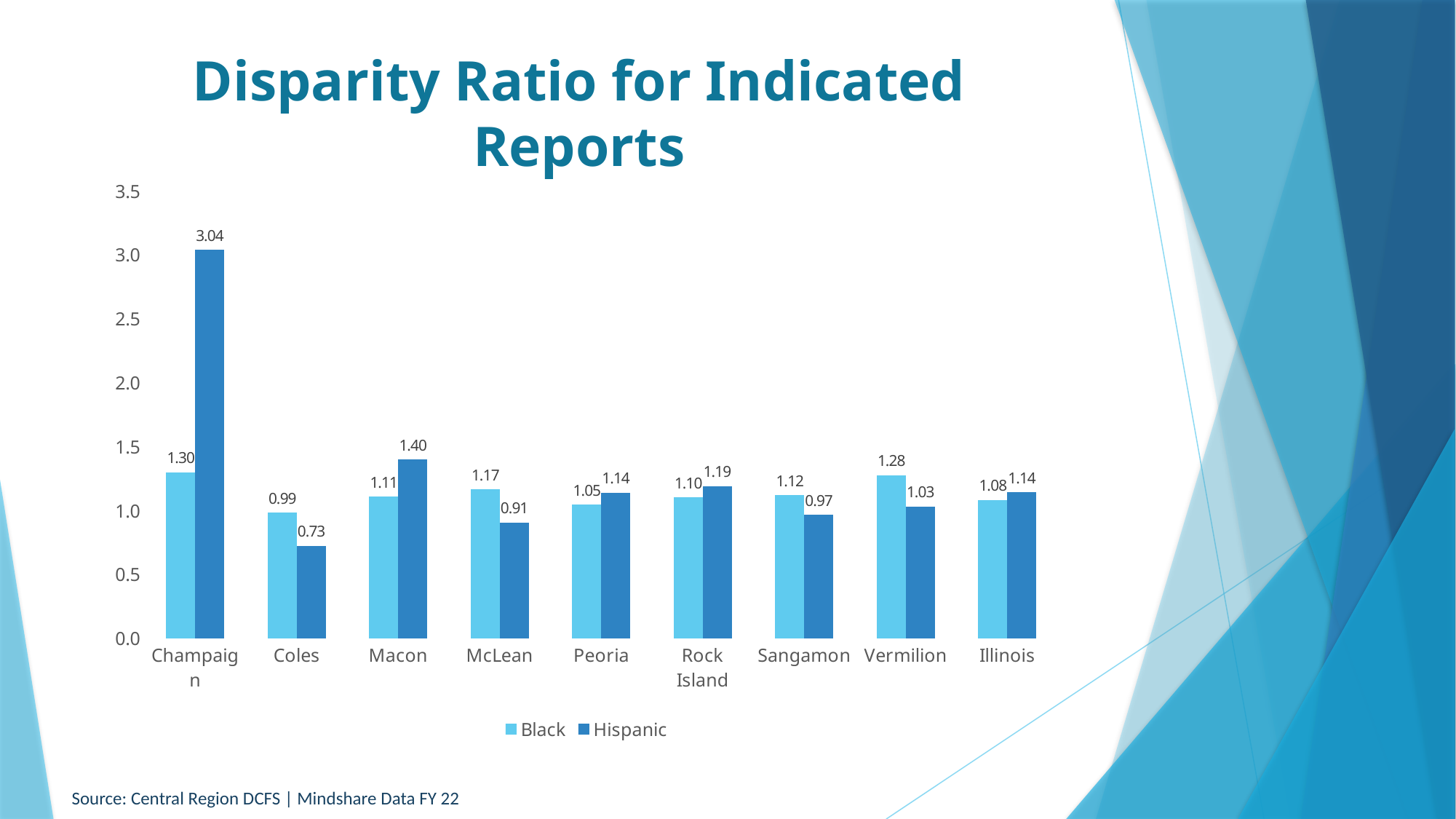
Which category has the lowest Black disparity ratio? Coles How many series does the legend list? 2 Is the Hispanic value for Champaign greater or less than 3.0? greater How many categories are shown on the x axis? 9 What is the difference between the Hispanic and Black disparity ratios for Champaign? 1.74 What kind of chart is shown on the slide? Bar chart Which is larger for McLean, the Black or the Hispanic disparity ratio? Black What is the Black disparity ratio for Vermilion? 1.28 What is the title of the chart? Disparity Ratio for Indicated Reports What is the Hispanic disparity ratio for Coles? 0.73 What is the Hispanic disparity ratio for Champaign? 3.04 Which category has the highest Hispanic disparity ratio? Champaign